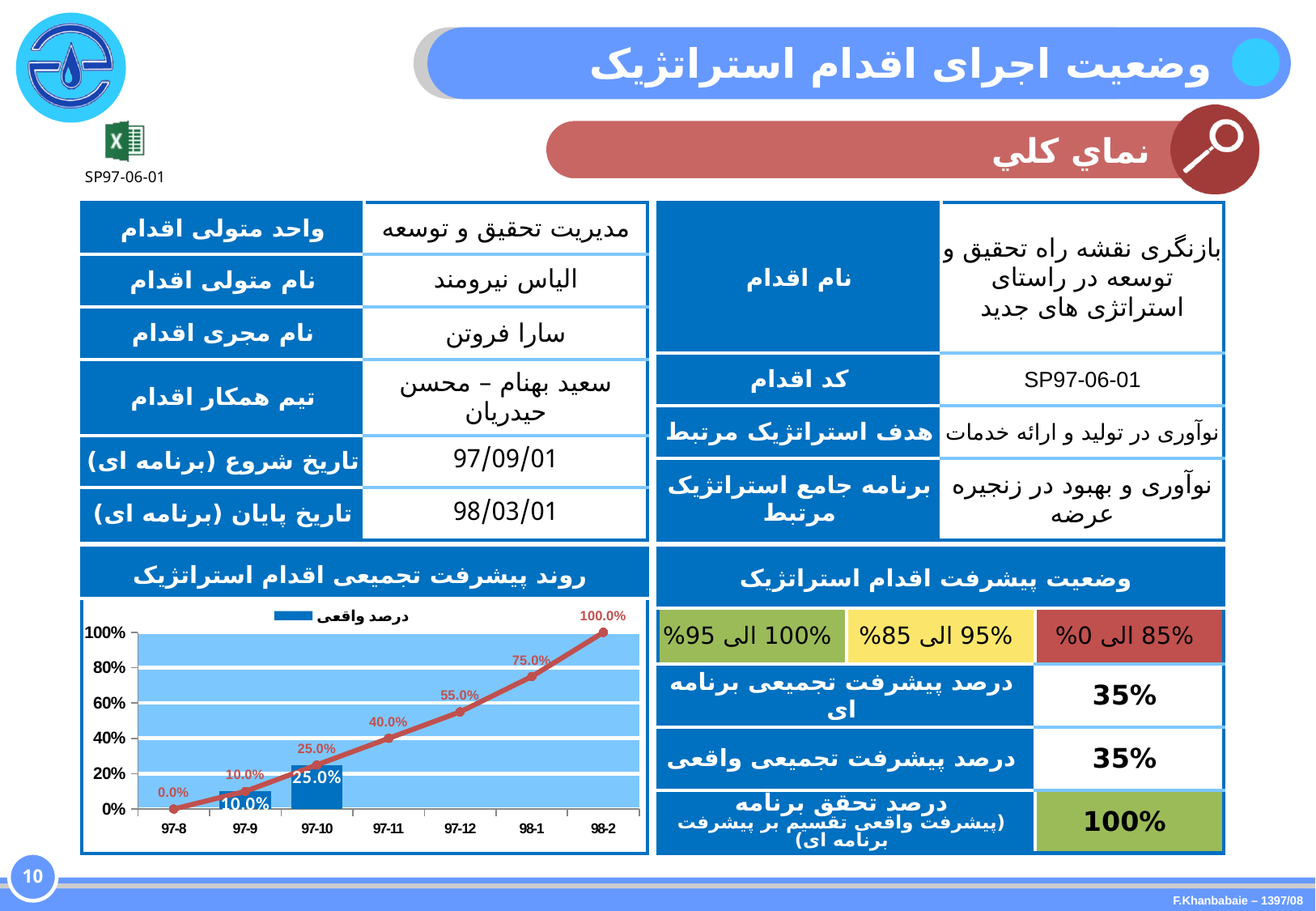
What is the difference between the line values for 98-1 and 97-12 in the chart? 20.0% How many series does the chart legend list? 1 Which category has the highest line value in the chart? 98-2 Do the line values rise or fall from 97-8 to 98-2 in the chart? rise What is the bar value (درصد واقعی) for 97-10 in the chart? 25.0% How many categories are shown on the x axis of the chart? 7 What is the line value for 97-11 in the chart? 40.0% What is the title of the chart on the slide? روند پیشرفت تجمیعی اقدام استراتژیک What is the line value for 98-2 in the chart? 100.0% Which is larger in the chart: the line value for 97-12 or the line value for 97-11? 97-12 What is the bar value (درصد واقعی) for 97-9 in the chart? 10.0% Which category has the lowest line value in the chart? 97-8